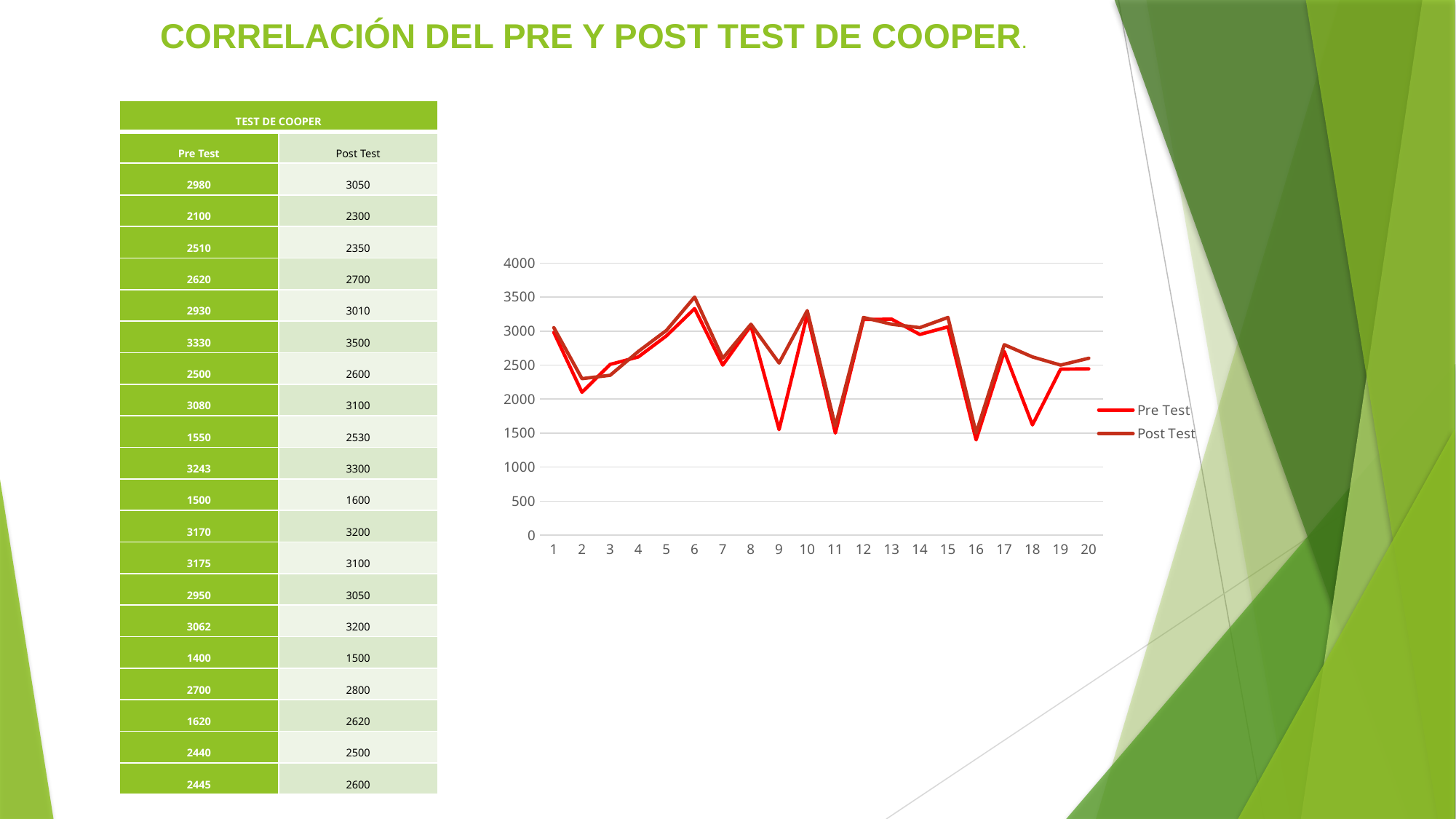
What kind of chart is shown on the slide? line chart Using the table values, what is the difference between the Post Test (2530) and Pre Test (1550) for the 9th participant? 980 At which x-axis point does the Pre Test series reach its lowest value? 16 How many series does the chart legend list? 2 According to the table, what is the Post Test value for the 6th participant (Pre Test 3330)? 3500 Is the Pre Test value at point 9 greater or less than 2000? less At which x-axis point does the Post Test series reach its highest value? 6 Is the Post Test value at point 6 greater or less than 3000? greater At point 18, which series has the larger value, Pre Test or Post Test? Post Test Do both series rise or fall from point 1 to point 2? fall How many points are plotted along the x axis of the chart? 20 At point 9, which series has the larger value, Pre Test or Post Test? Post Test